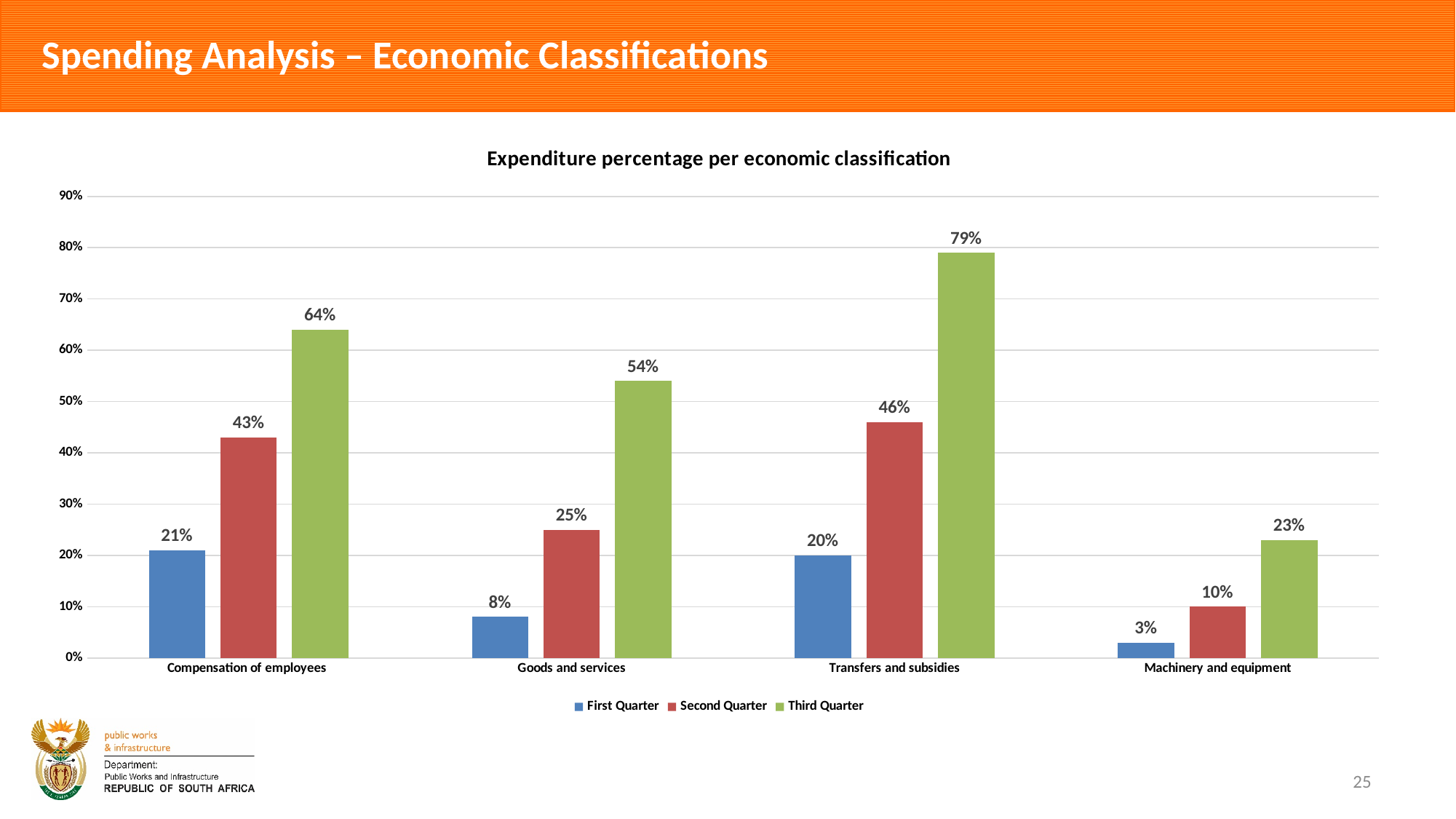
What is the Third Quarter value for Transfers and subsidies? 79% Which category has the lowest First Quarter value? Machinery and equipment Which is larger: the Second Quarter value for Goods and services or the First Quarter value for Compensation of employees? Second Quarter value for Goods and services Which category has the highest Third Quarter value? Transfers and subsidies What is the Second Quarter value for Machinery and equipment? 10% What is the First Quarter value for Goods and services? 8% How many categories are shown on the x axis? 4 What is the title of the chart? Expenditure percentage per economic classification What is the difference between the Third Quarter and Second Quarter values for Compensation of employees? 21% Is the Third Quarter value for Goods and services greater or less than 50%? greater What kind of chart is shown on the slide? Bar chart How many series does the legend list? 3